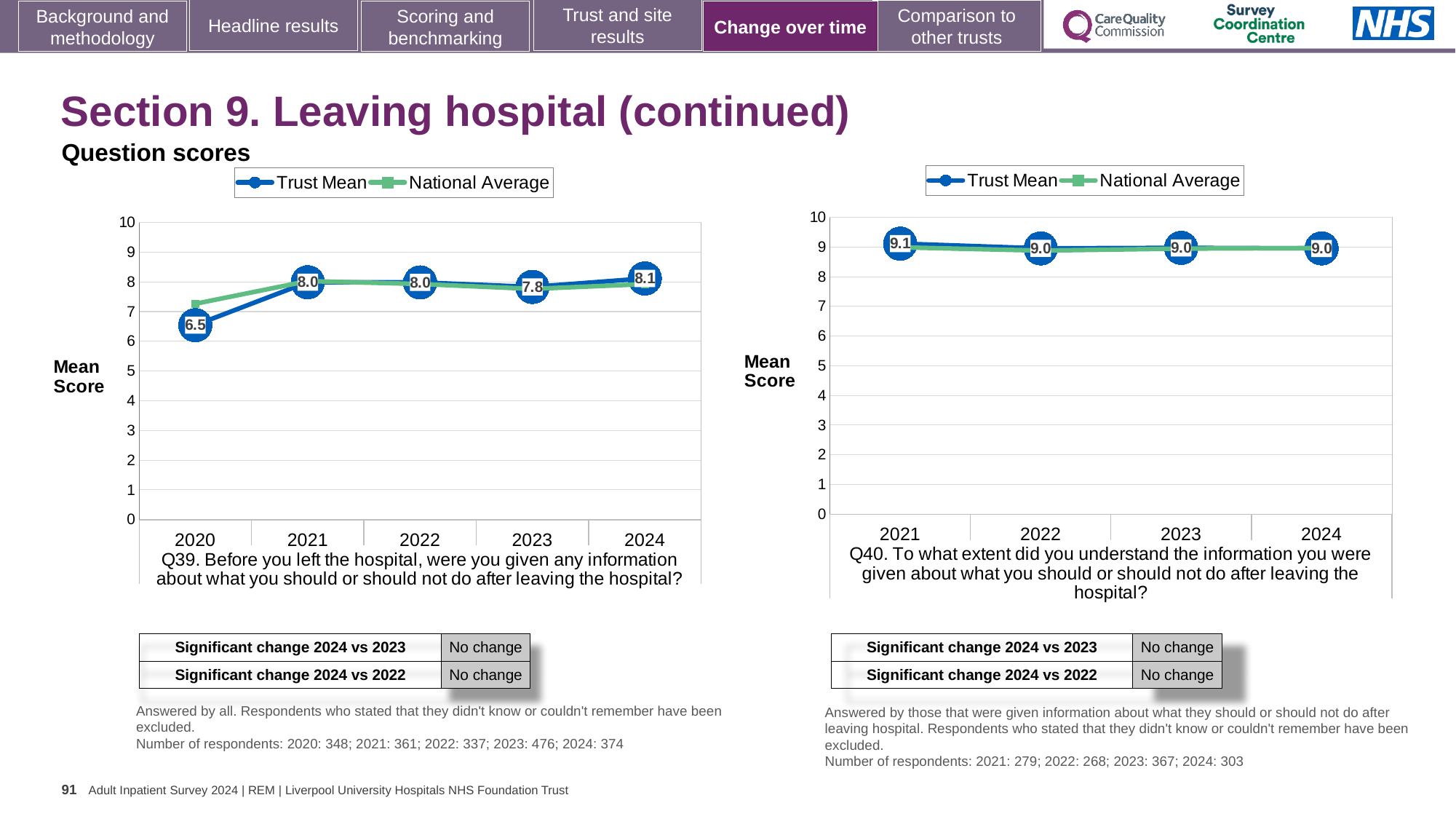
On the Q40 chart (right), what is the Trust Mean score for 2021? 9.1 On the Q39 chart (left), does the Trust Mean rise or fall from 2020 to 2021? rise What kind of chart is the Q40 chart (right)? line chart On the Q39 chart (left), is the Trust Mean score higher in 2021 or in 2023? 2021 On the Q39 chart (left), is the National Average value for 2020 greater or less than 7? greater On the Q40 chart (right), which year has the highest Trust Mean score? 2021 On the Q39 chart (left), what is the Trust Mean score for 2020? 6.5 On the Q39 chart (left), what is the difference between the Trust Mean scores for 2024 and 2020? 1.6 On the Q39 chart (left), what is the Trust Mean score for 2024? 8.1 On the Q39 chart (left), which year has the lowest Trust Mean score? 2020 On the Q40 chart (right), how many series does the legend list? 2 On the Q39 chart (left), how many years are plotted on the x axis? 5